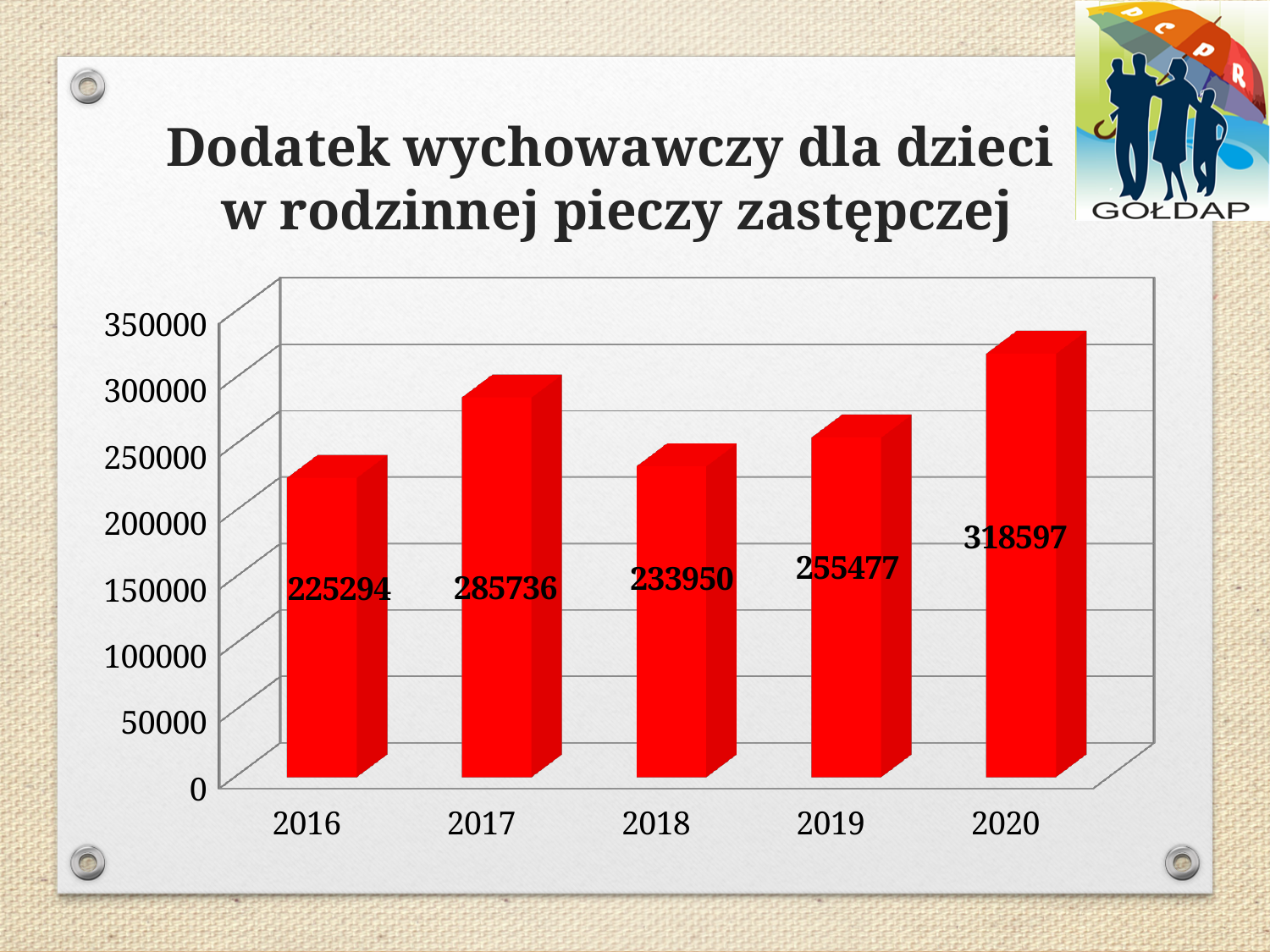
What is the value for 2020? 318597 Is the value for 2019 greater or less than 300000? less Which is larger, the value for 2017 or the value for 2019? 2017 What is the difference between the values for 2017 and 2018? 51786 What is the title of the chart? Dodatek wychowawczy dla dzieci w rodzinnej pieczy zastępczej How many years are shown on the x axis? 5 Which year has the lowest value? 2016 What kind of chart is shown on the slide? bar chart Which year has the highest value? 2020 What is the value for 2016? 225294 What is the value for 2018? 233950 What is the difference between the values for 2020 and 2016? 93303